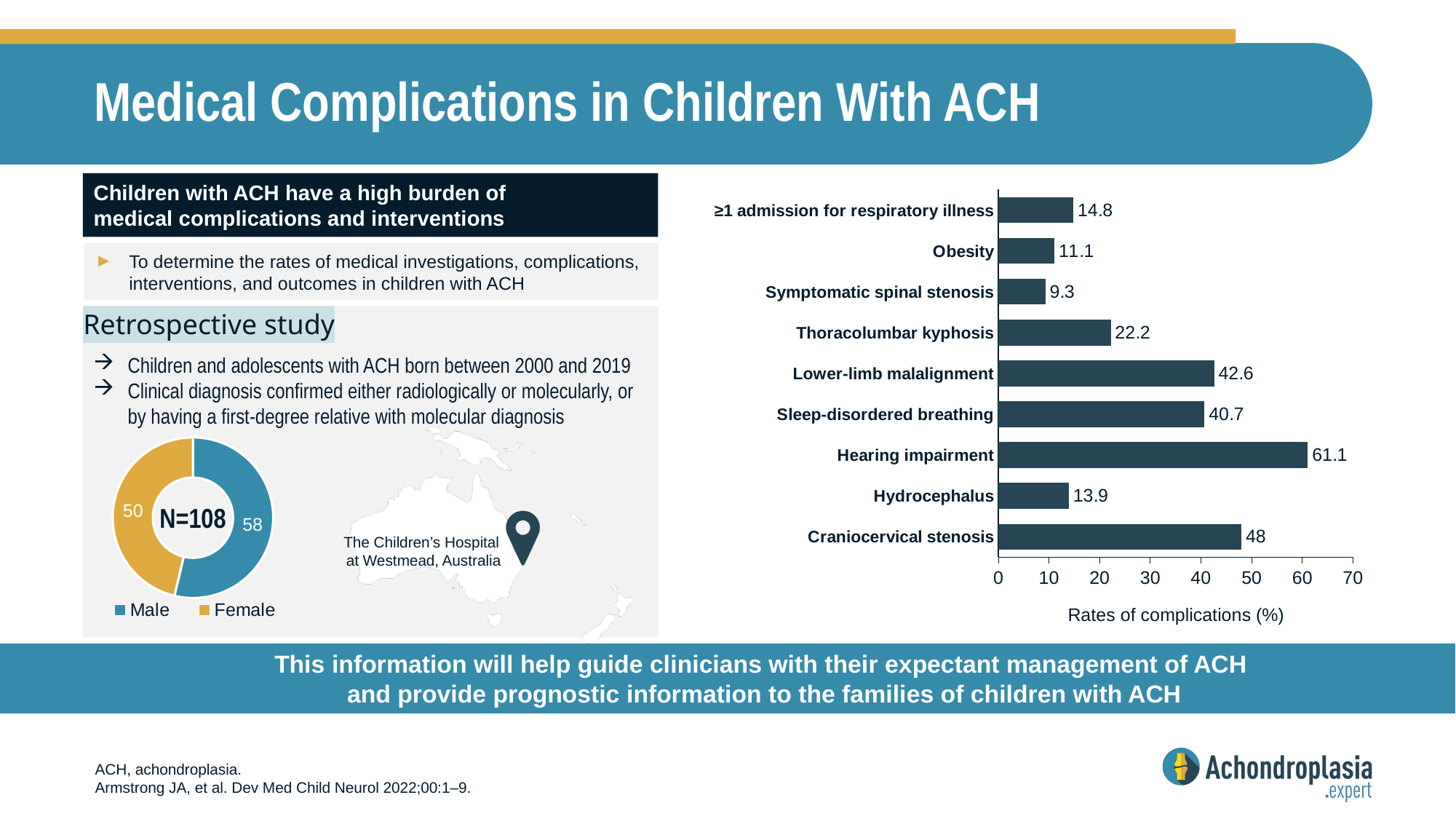
In the bar chart of complication rates, which complication has the highest rate? Hearing impairment In the bar chart of complication rates, what is the value for Craniocervical stenosis? 48 In the donut chart on the left, what is the total number of participants shown in the centre? N=108 In the bar chart of complication rates, what is the value for Symptomatic spinal stenosis? 9.3 In the bar chart of complication rates, which is larger: the rate for Thoracolumbar kyphosis or the rate for Hydrocephalus? Thoracolumbar kyphosis What kind of chart is used to show the rates of complications? Bar chart In the bar chart of complication rates, what is the value for Hearing impairment? 61.1 In the donut chart on the left, how many participants are Male? 58 In the bar chart of complication rates, which complication has the lowest rate? Symptomatic spinal stenosis In the bar chart of complication rates, what is the difference between the rates for Lower-limb malalignment and Sleep-disordered breathing? 1.9 In the bar chart of complication rates, what is the label of the horizontal axis? Rates of complications (%) In the bar chart of complication rates, how many complications are listed? 9